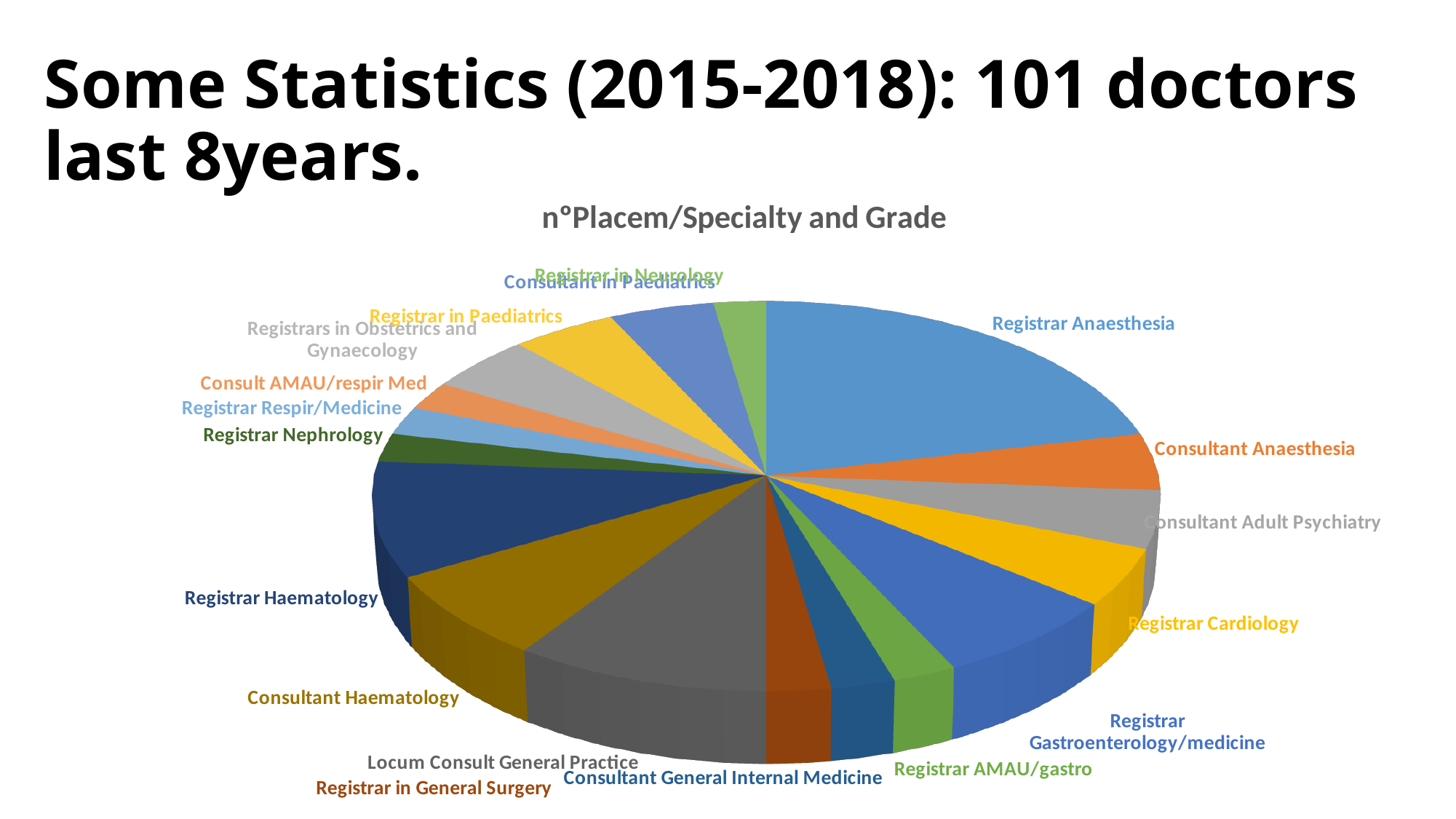
Which slice is larger, Registrar Gastroenterology/medicine or Consult AMAU/respir Med? Registrar Gastroenterology/medicine How many categories (slices) are labelled on the pie chart? 18 What colour is the Registrar Anaesthesia slice? Blue Which category has the largest slice of the pie? Registrar Anaesthesia What kind of chart is shown on the slide? Pie chart Which slice is larger, Consultant Haematology or Registrar in Neurology? Consultant Haematology Which slice is larger, Registrar Haematology or Registrar Nephrology? Registrar Haematology What is the title of the chart? n°Placem/Specialty and Grade